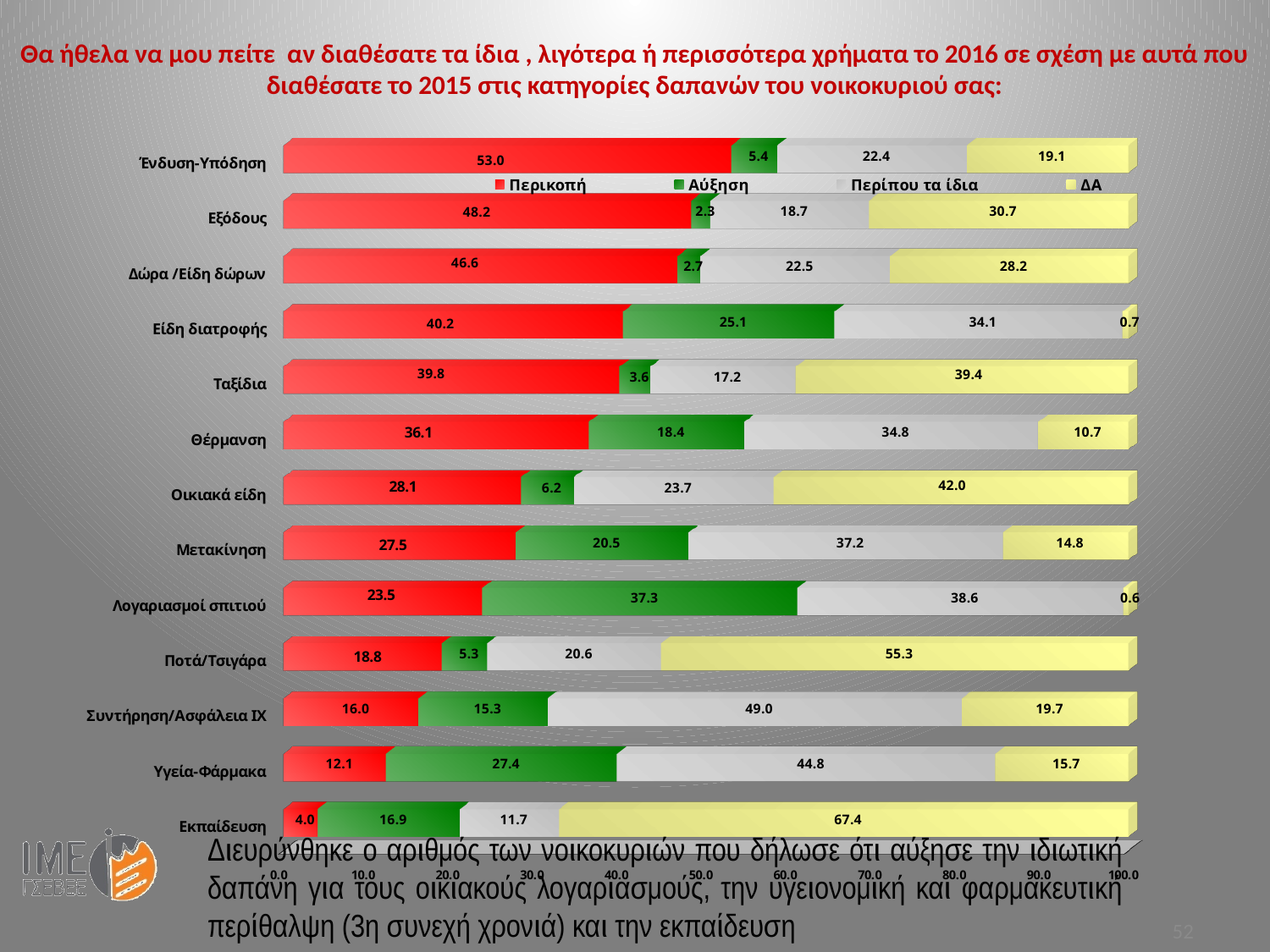
What colour represents the Αύξηση series? Green Which is larger: the Περίπου τα ίδια value for Συντήρηση/Ασφάλεια ΙΧ or for Υγεία-Φάρμακα? Συντήρηση/Ασφάλεια ΙΧ What is the Περικοπή value for Ένδυση-Υπόδηση? 53.0 What is the ΔΑ value for Εκπαίδευση? 67.4 What is the Αύξηση value for Λογαριασμοί σπιτιού? 37.3 Which category has the highest Περικοπή value? Ένδυση-Υπόδηση Which category has the highest Αύξηση value? Λογαριασμοί σπιτιού How many series does the legend list? 4 Which category has the lowest Περικοπή value? Εκπαίδευση What type of chart is shown on the slide? Stacked bar chart How many expense categories are shown on the chart? 13 What is the difference between the Περικοπή values for Ένδυση-Υπόδηση and Εξόδους? 4.8